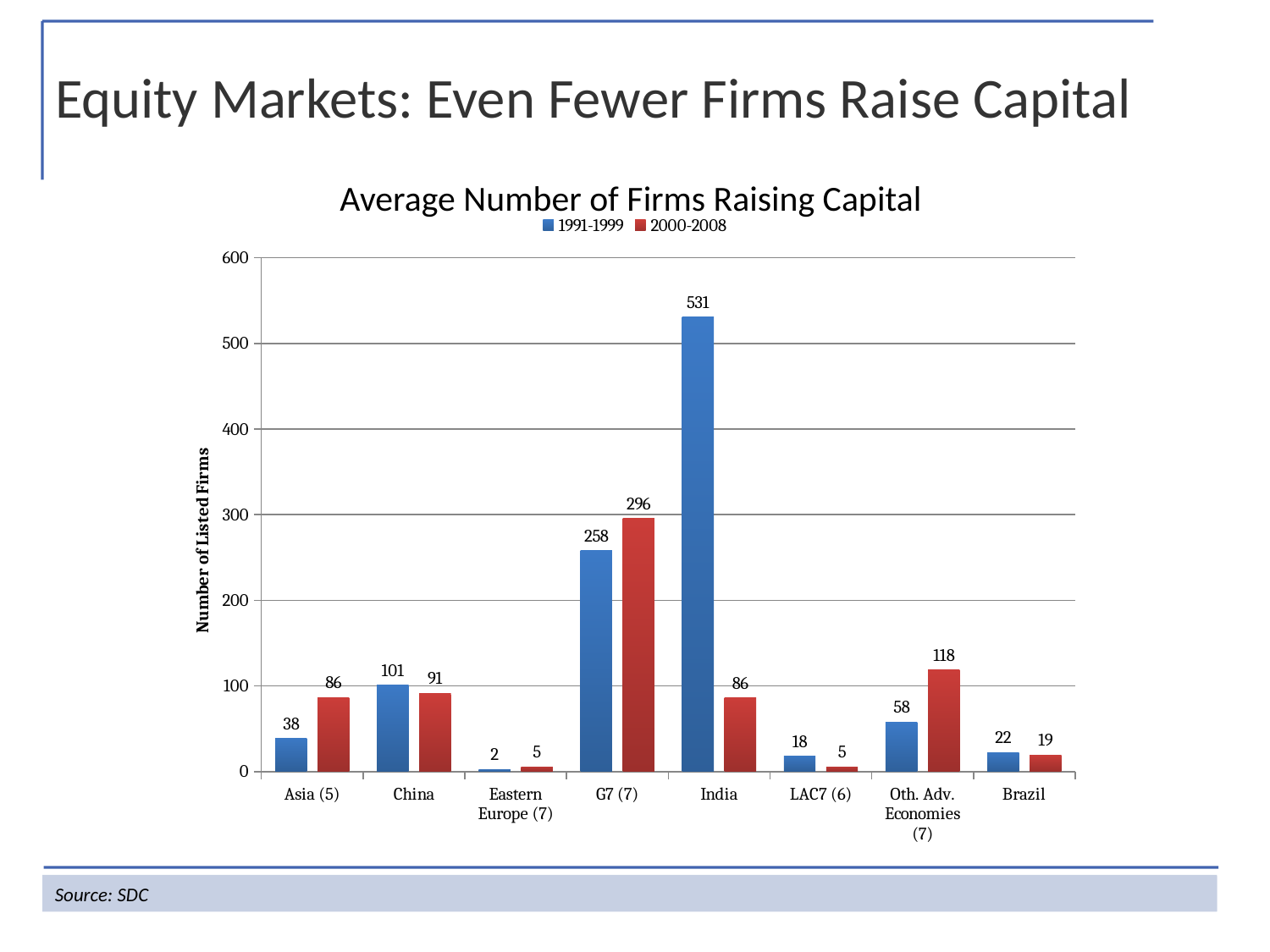
What kind of chart is shown on the slide? Bar chart What is the title of the chart? Average Number of Firms Raising Capital Which is larger for G7 (7): the 1991-1999 value or the 2000-2008 value? 2000-2008 What is the value for India in the 1991-1999 series? 531 Which category has the highest value in the 1991-1999 series? India What is the value for Oth. Adv. Economies (7) in the 2000-2008 series? 118 How many categories are shown on the x axis? 8 How many series does the legend list? 2 What is the value for G7 (7) in the 1991-1999 series? 258 What is the label of the y axis? Number of Listed Firms Which category has the lowest value in the 2000-2008 series? Eastern Europe (7) and LAC7 (6) (tied at 5) What is the difference between the 1991-1999 and 2000-2008 values for India? 445